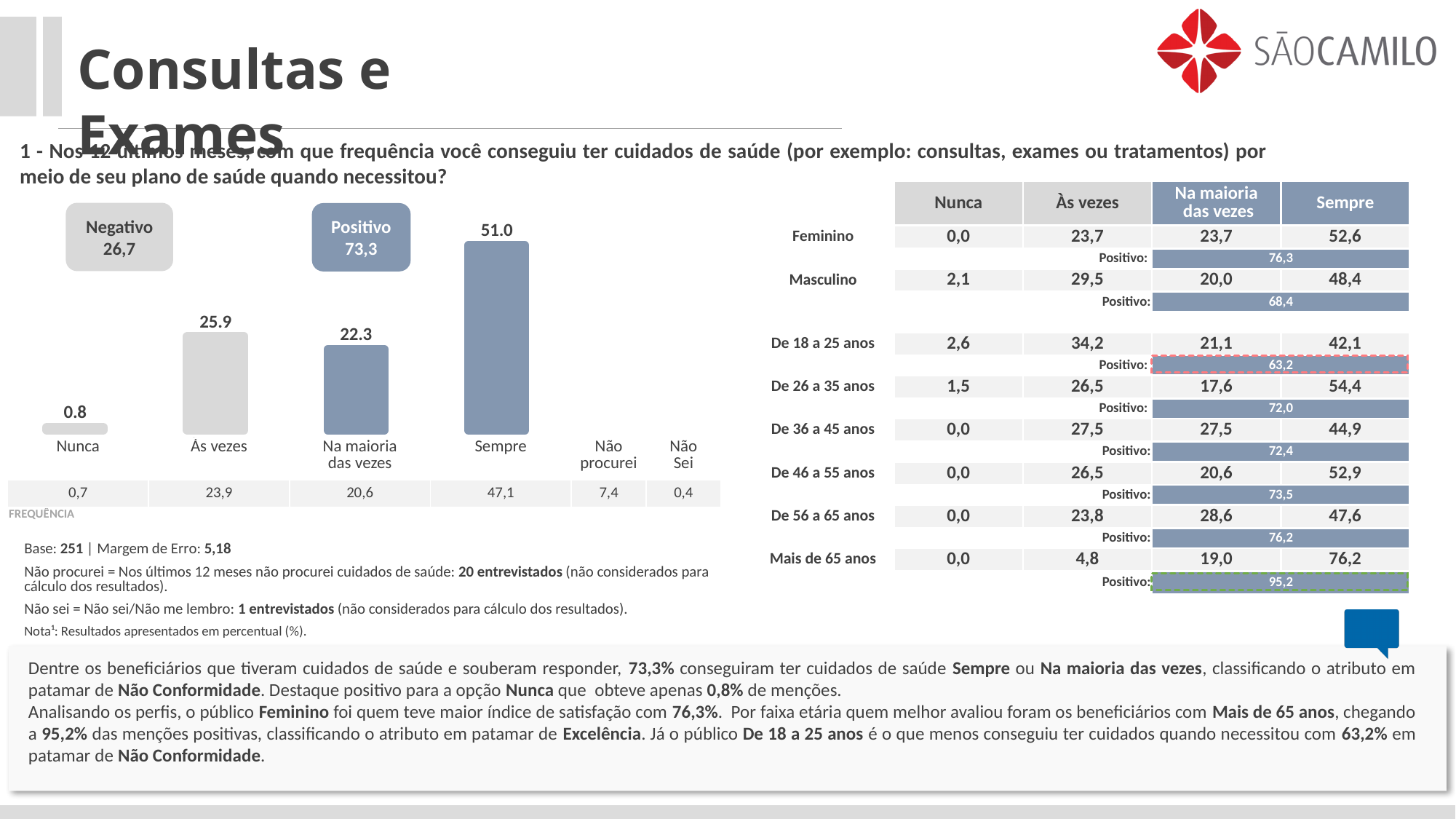
What is the difference between the bars for Sempre and Às vezes in the bar chart? 25.1 What is the value of the bar for Na maioria das vezes in the bar chart? 22.3 Which category has the lowest bar in the bar chart? Nunca What is the value of the bar for Nunca in the bar chart? 0.8 How many bars with data labels are plotted in the bar chart? 4 What is the value of the bar for Sempre in the bar chart? 51.0 What type of chart is shown on the left of the slide? Bar chart What is the value of the bar for Às vezes in the bar chart? 25.9 What value is shown in the 'Negativo' box above the bar chart? 26,7 Which bar is larger in the bar chart, Às vezes or Na maioria das vezes? Às vezes Which category has the highest bar in the bar chart? Sempre What value is shown in the 'Positivo' box above the bar chart? 73,3